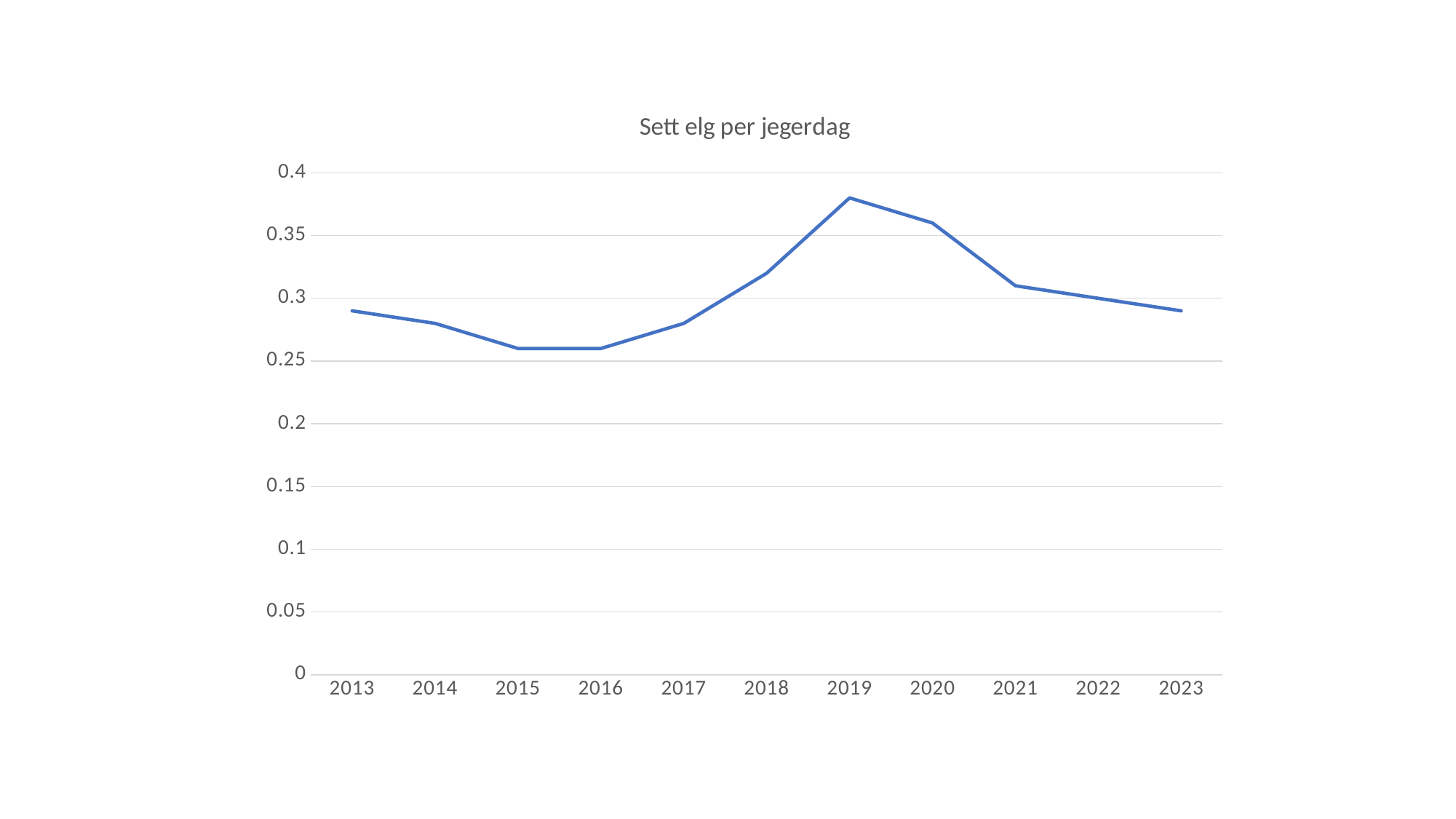
Is the value for 2020 greater or less than 0.3? greater Which year has the highest value? 2019 Is the value for 2017 greater or less than 0.25? greater What kind of chart is shown on the slide? Line chart Is the value for 2016 greater or less than 0.3? less Which is larger, the value for 2019 or the value for 2015? 2019 Do the values rise or fall from 2016 to 2019? rise What is the title of the chart? Sett elg per jegerdag Do the values rise or fall from 2019 to 2023? fall How many years are plotted along the x axis? 11